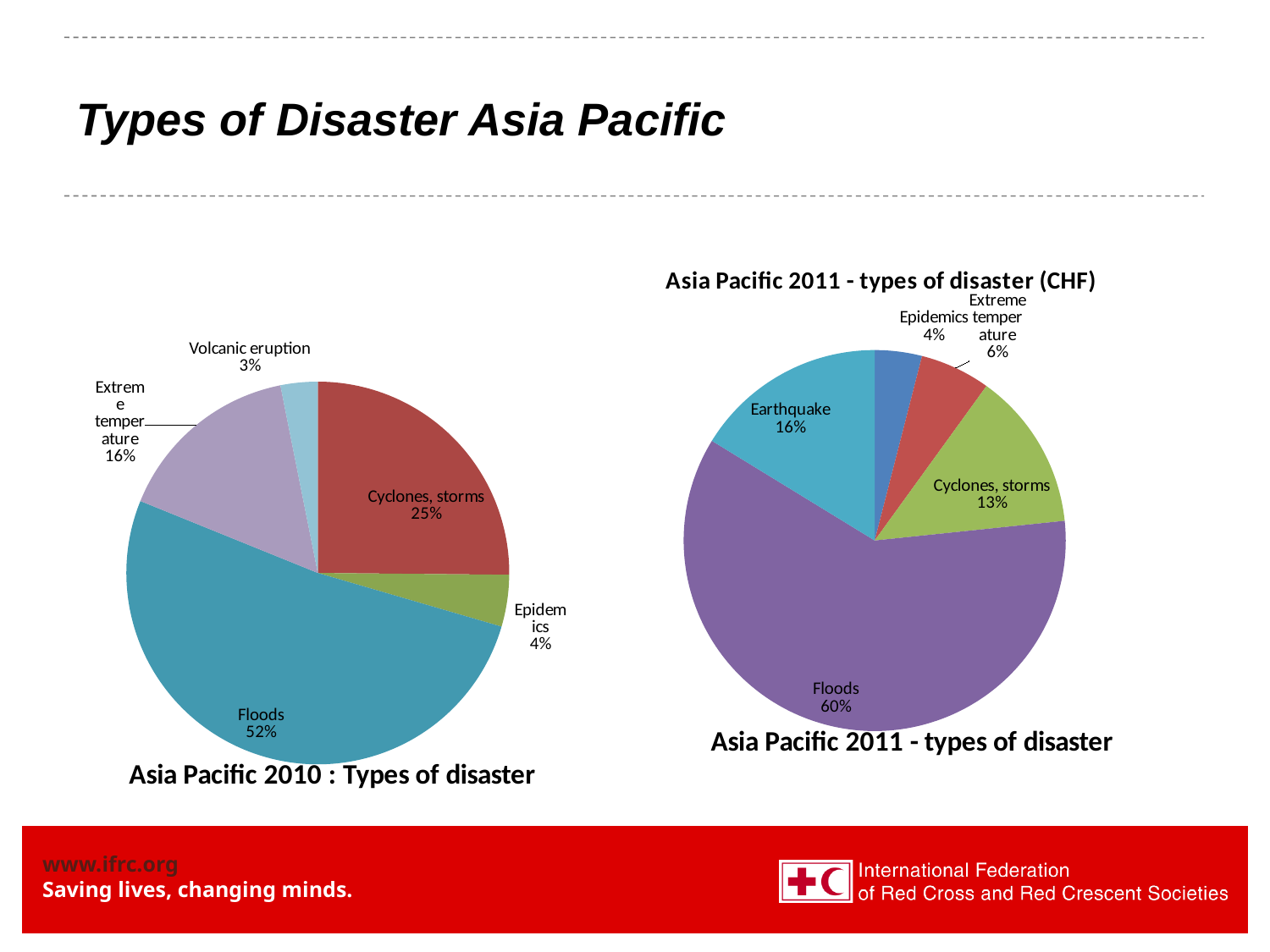
In the 'Asia Pacific 2011 - types of disaster (CHF)' pie chart, what share do Floods have? 60% In the 'Asia Pacific 2010 : Types of disaster' pie chart, what is the difference between the shares of Floods and Cyclones, storms? 27% How many charts are on the slide? 2 In the 'Asia Pacific 2010 : Types of disaster' pie chart, what share do Floods have? 52% In the 'Asia Pacific 2010 : Types of disaster' pie chart, which category has the smallest share? Volcanic eruption In the 'Asia Pacific 2011 - types of disaster (CHF)' pie chart, how many categories are shown? 5 In the 'Asia Pacific 2011 - types of disaster (CHF)' pie chart, what share does Earthquake have? 16% In the 'Asia Pacific 2010 : Types of disaster' pie chart, what share do Cyclones, storms have? 25% In the 'Asia Pacific 2010 : Types of disaster' pie chart, how many categories are shown? 5 In the 'Asia Pacific 2011 - types of disaster (CHF)' pie chart, which category has the largest share? Floods In the 'Asia Pacific 2011 - types of disaster (CHF)' pie chart, which is larger: Cyclones, storms or Extreme temperature? Cyclones, storms What kind of chart is the 'Asia Pacific 2010 : Types of disaster' chart? Pie chart